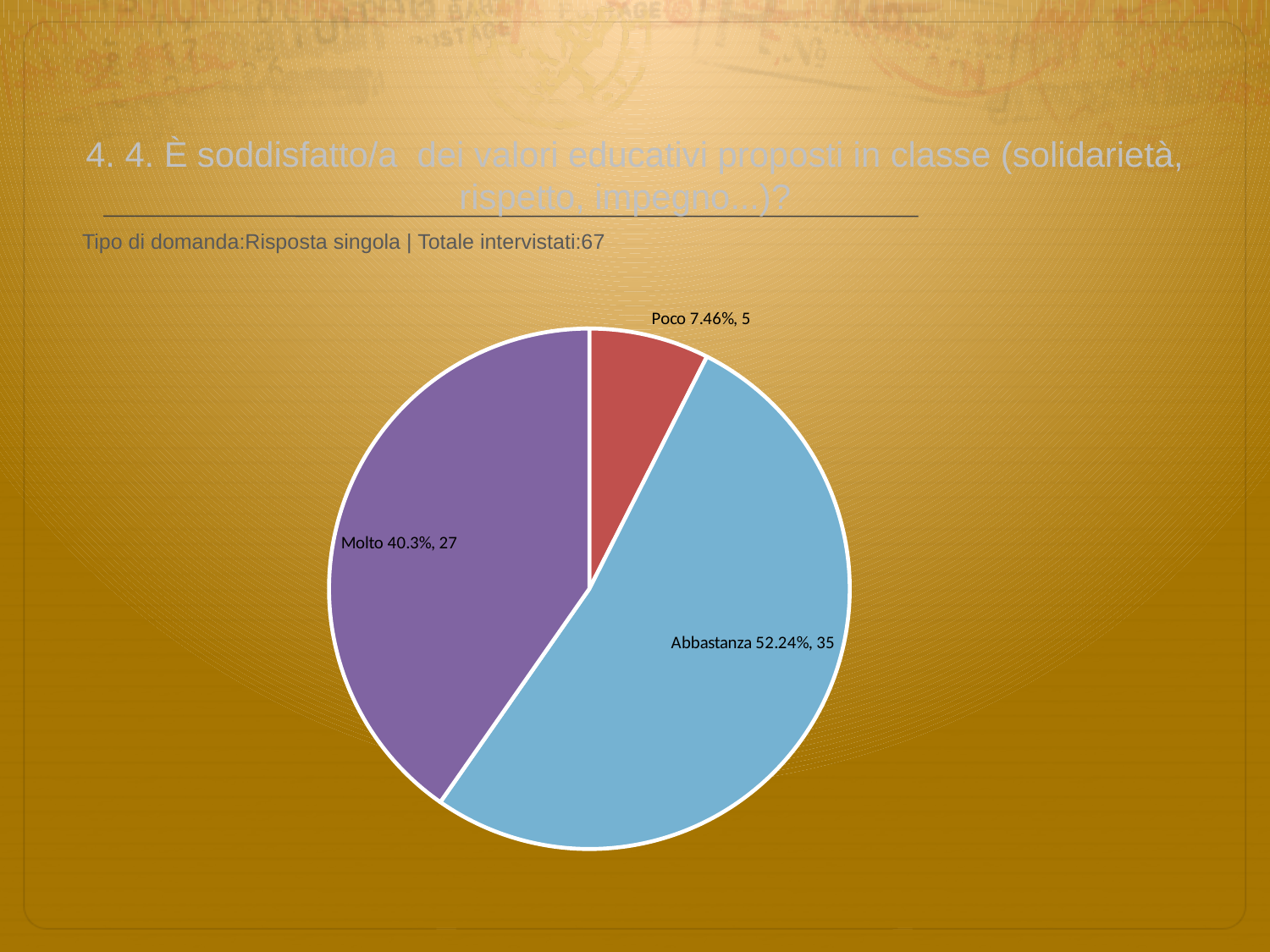
What is the difference in respondent count between Abbastanza and Molto? 8 How many respondents answered Molto? 27 How many respondents answered Abbastanza? 35 Which response has the smallest slice of the pie? Poco How many slices does the pie chart have? 3 What kind of chart is shown on the slide? pie chart How many respondents answered Poco? 5 Which response has the largest slice of the pie? Abbastanza What percentage share does the Poco slice have? 7.46% Which slice is larger, Molto or Poco? Molto What percentage share does the Molto slice have? 40.3% What percentage share does the Abbastanza slice have? 52.24%